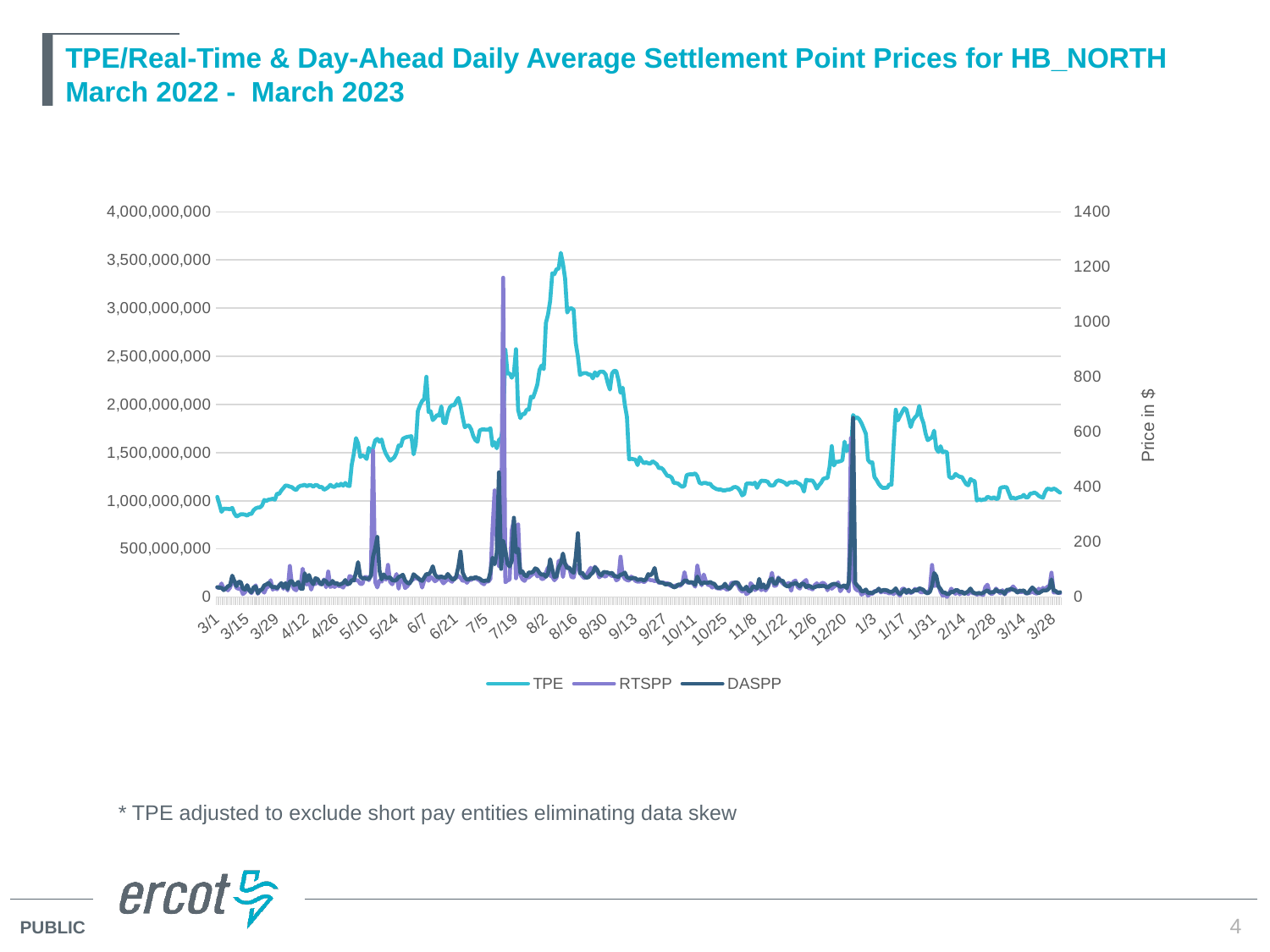
What is the highest tick value shown on the left vertical axis? 4,000,000,000 Is the peak value of the TPE line greater or less than 3,000,000,000 on the left axis? greater Is the peak value of the DASPP line greater or less than 800 on the right axis? less Does the TPE line rise or fall between 8/16 and 9/27? fall What kind of chart is shown on the slide? line chart How many series does the legend list? 3 What is the highest tick value shown on the right vertical axis? 1400 What are the three series named in the legend? TPE, RTSPP, DASPP Is the peak value of the RTSPP line greater or less than 1000 on the right axis? greater What is the label of the right-hand vertical axis? Price in $ In which month does the TPE line reach its highest point? August Which series reaches a higher peak on the right-hand price axis, RTSPP or DASPP? RTSPP